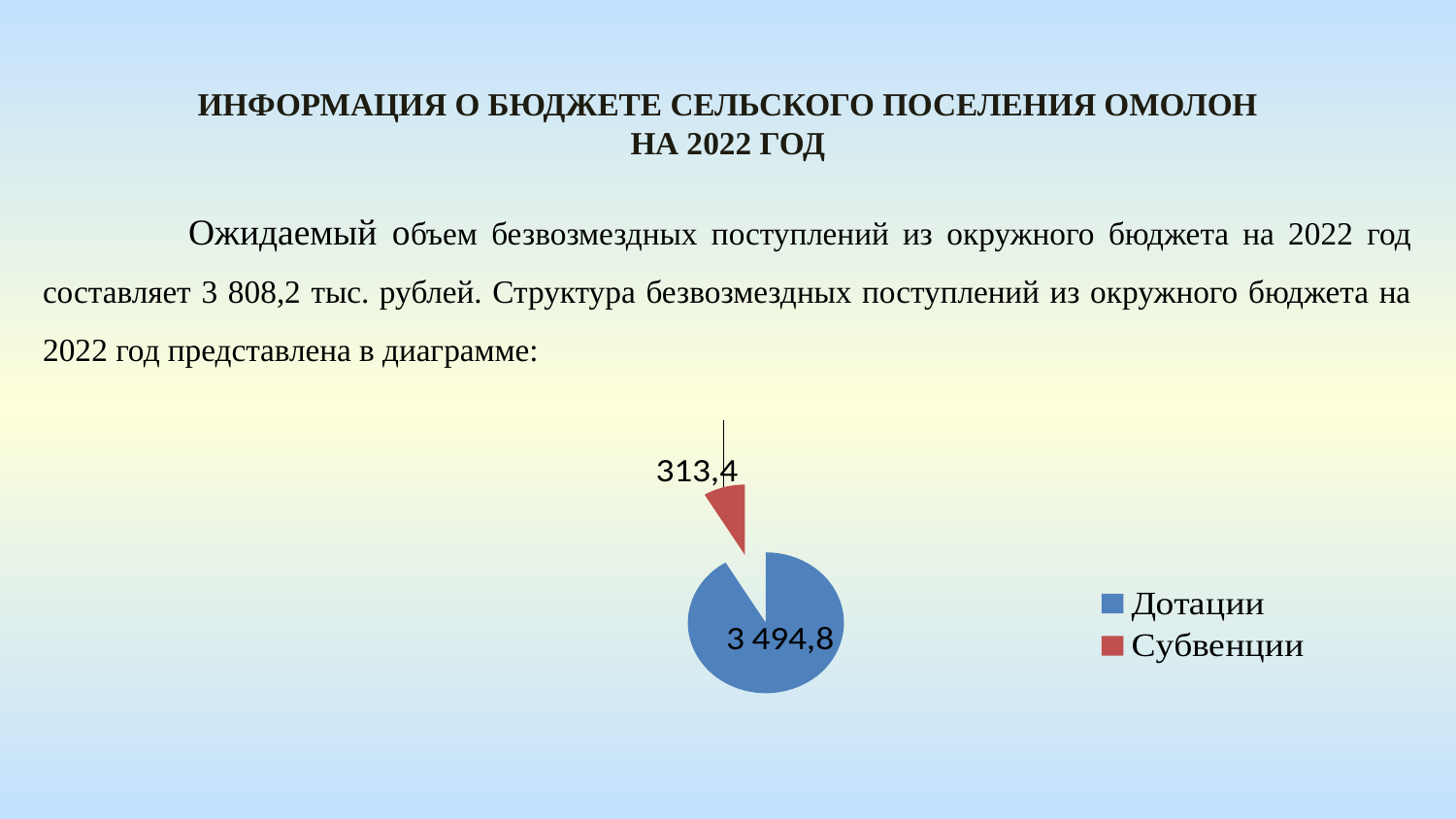
What is the difference between the values for Дотации and Субвенции? 3 181,4 What is the total of the two slices in the pie chart? 3 808,2 What is the value for Субвенции in the pie chart? 313,4 What is the value for Дотации in the pie chart? 3 494,8 Which is larger, Дотации or Субвенции? Дотации Which category has the smallest slice in the pie chart? Субвенции How many slices does the pie chart have? 2 What type of chart is shown on the slide? Pie chart What colour is the Субвенции slice in the pie chart? Red How many entries does the legend list? 2 Which category has the largest slice in the pie chart? Дотации